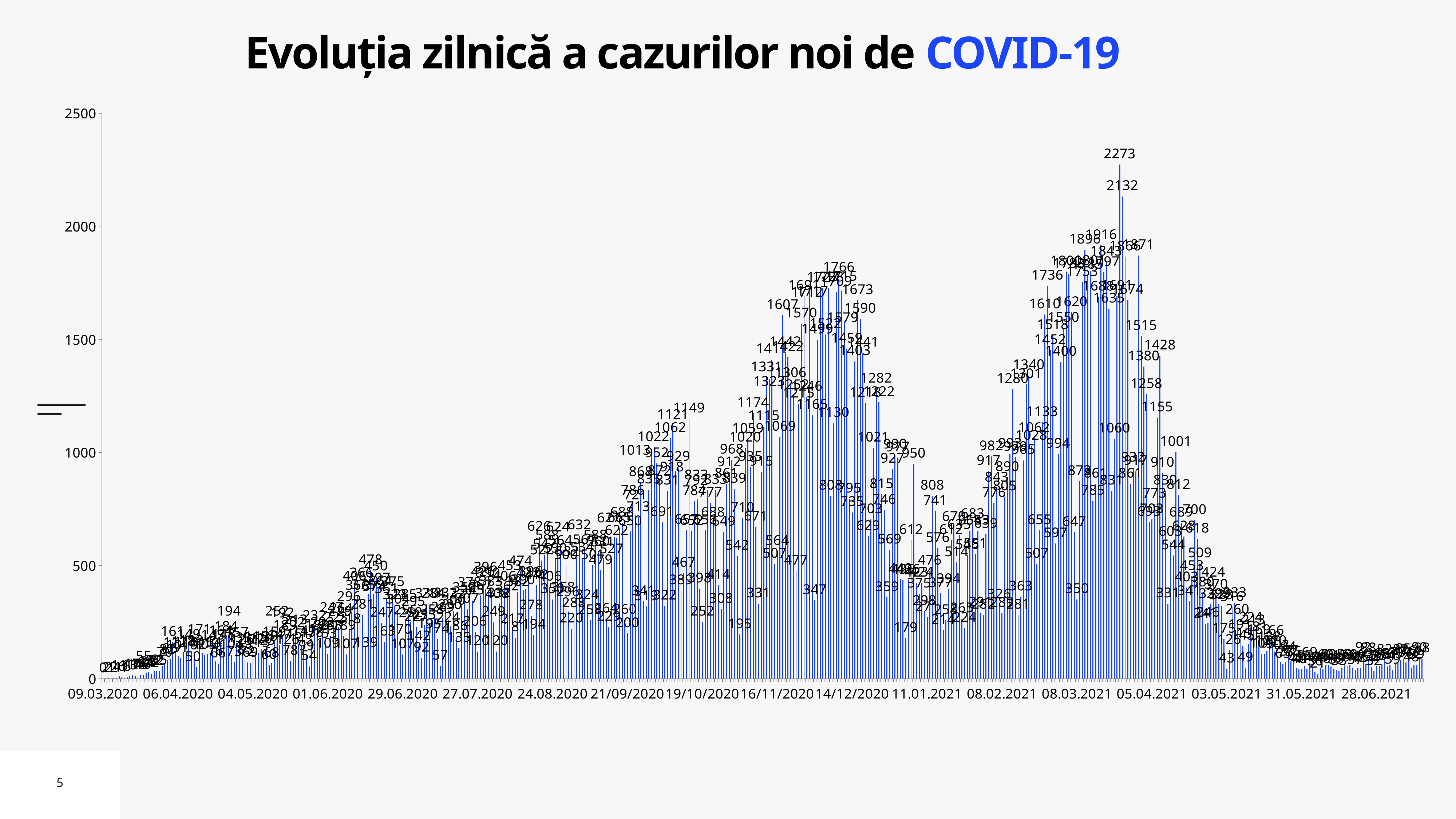
What kind of chart is shown on the slide? bar chart What is the difference between the bars labelled 2273 and 2132? 141 What is the maximum value shown on the y axis? 2500 Do the values rise or fall along the x axis between 09.03.2020 and 06.04.2020? rise Is the highest value on the chart greater or less than 2000? greater Which is larger, the bar labelled 2273 or the bar labelled 2132? 2273 Do the values rise or fall along the x axis between 05.04.2021 and 28.06.2021? fall What is the first date shown on the x axis? 09.03.2020 Is the highest value on the chart greater or less than 2500? less What is the highest daily value labelled on the chart? 2273 What is the second-highest daily value labelled on the chart, next to the 2273 peak? 2132 What is the title of the chart? Evoluția zilnică a cazurilor noi de COVID-19